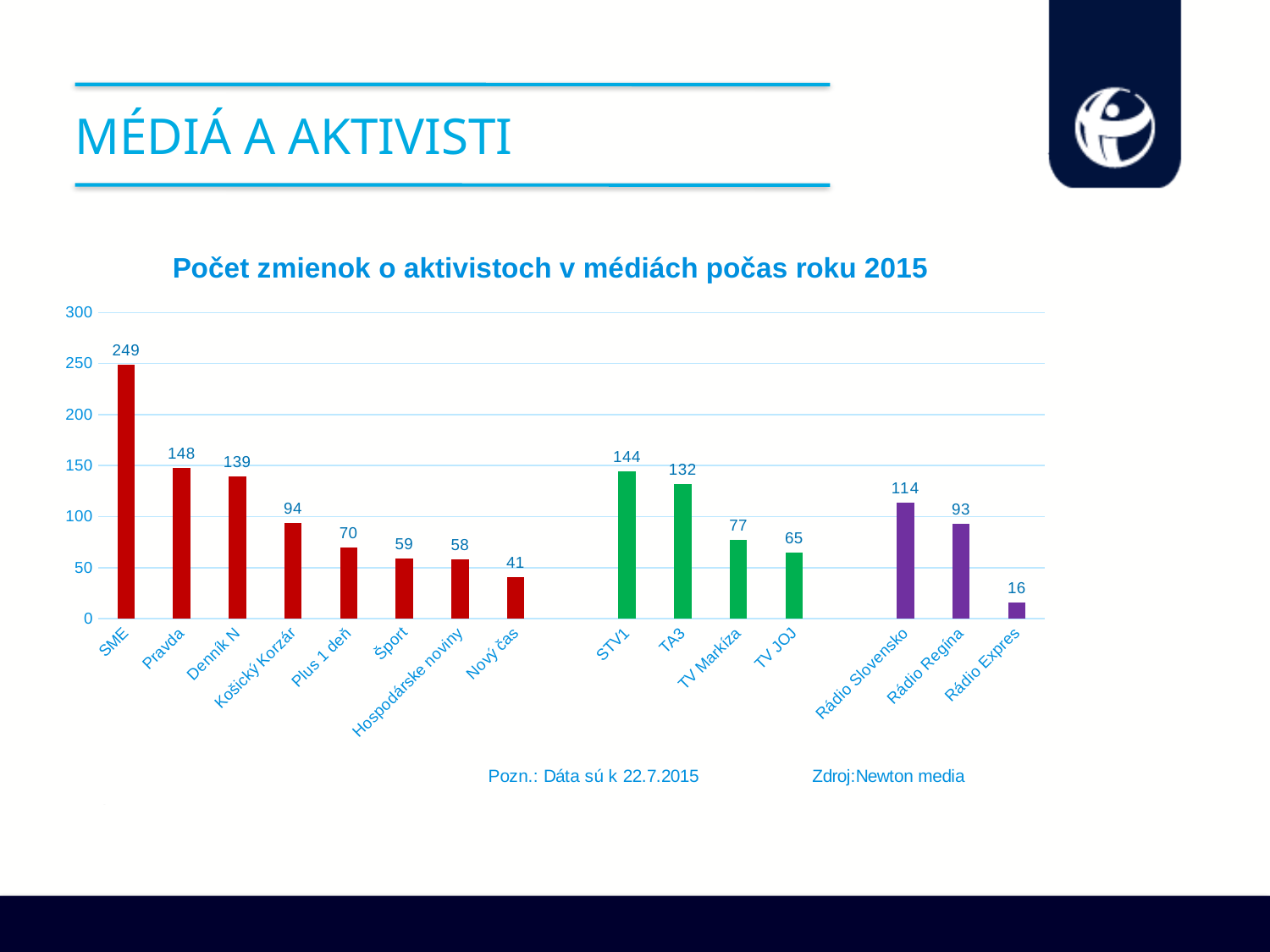
What is the title of the chart? Počet zmienok o aktivistoch v médiách počas roku 2015 What colour are the bars for STV1, TA3, TV Markíza and TV JOJ? green What is the value for Rádio Slovensko? 114 How many categories are shown on the x axis? 15 Which category has the lowest value? Rádio Expres Which category has the highest value? SME Is the value for Košický Korzár greater or less than 100? less What is the value for TV Markíza? 77 Which is larger, the value for Pravda or the value for STV1? Pravda What kind of chart is this? bar chart What is the difference between the values for STV1 and TA3? 12 What is the value for SME? 249